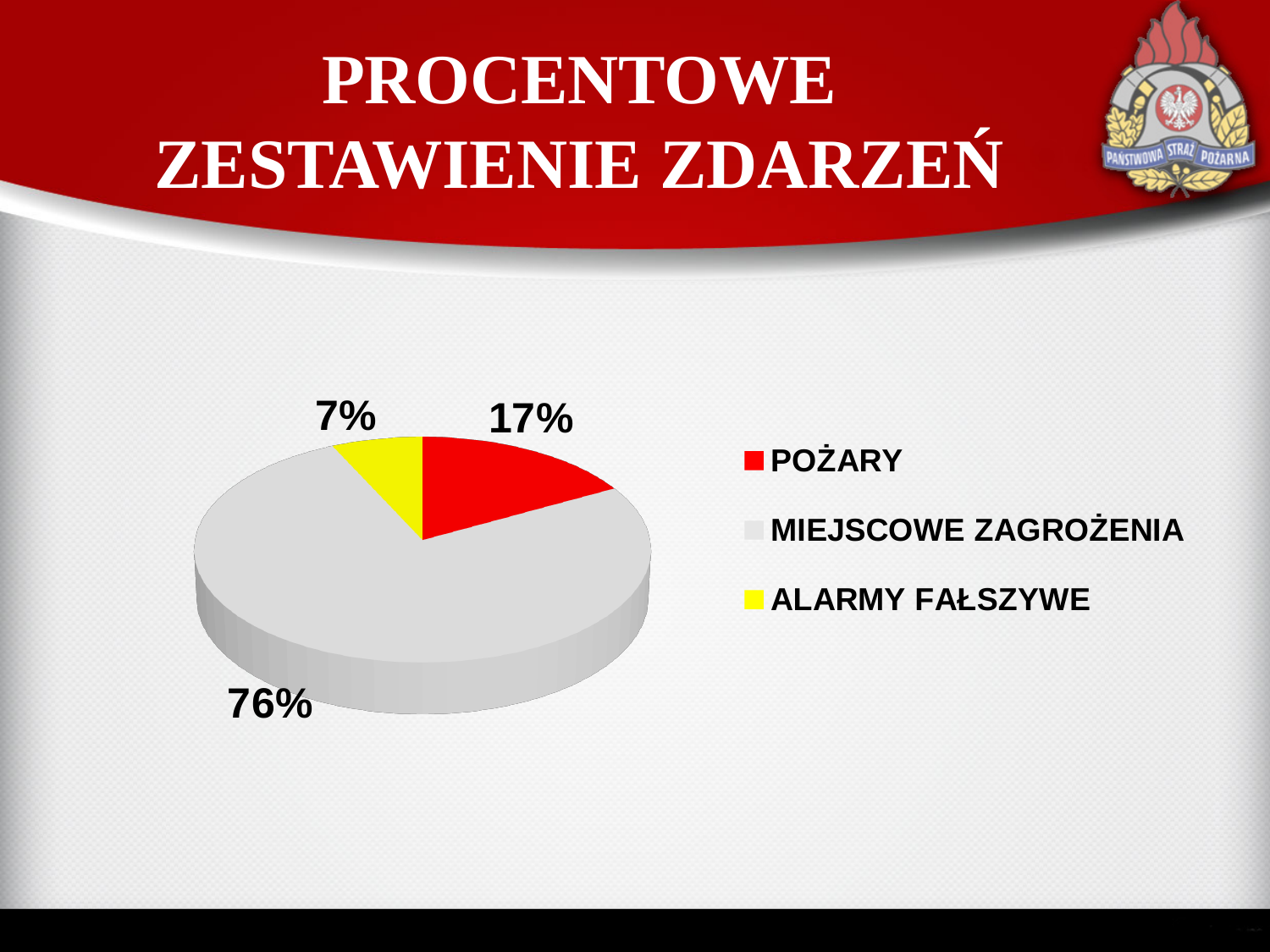
What colour is the slice for POŻARY? Red What share of the pie does MIEJSCOWE ZAGROŻENIA represent? 76% What kind of chart is shown on the slide? Pie chart Which category has the smallest slice of the pie? ALARMY FAŁSZYWE Which is larger, the share for POŻARY or the share for ALARMY FAŁSZYWE? POŻARY What share of the pie does ALARMY FAŁSZYWE represent? 7% How many categories are shown in the pie chart? 3 What is the difference in percentage points between MIEJSCOWE ZAGROŻENIA and POŻARY? 59 What is the difference in percentage points between POŻARY and ALARMY FAŁSZYWE? 10 Which category has the largest slice of the pie? MIEJSCOWE ZAGROŻENIA What is the title of the slide containing the chart? PROCENTOWE ZESTAWIENIE ZDARZEŃ What share of the pie does POŻARY represent? 17%